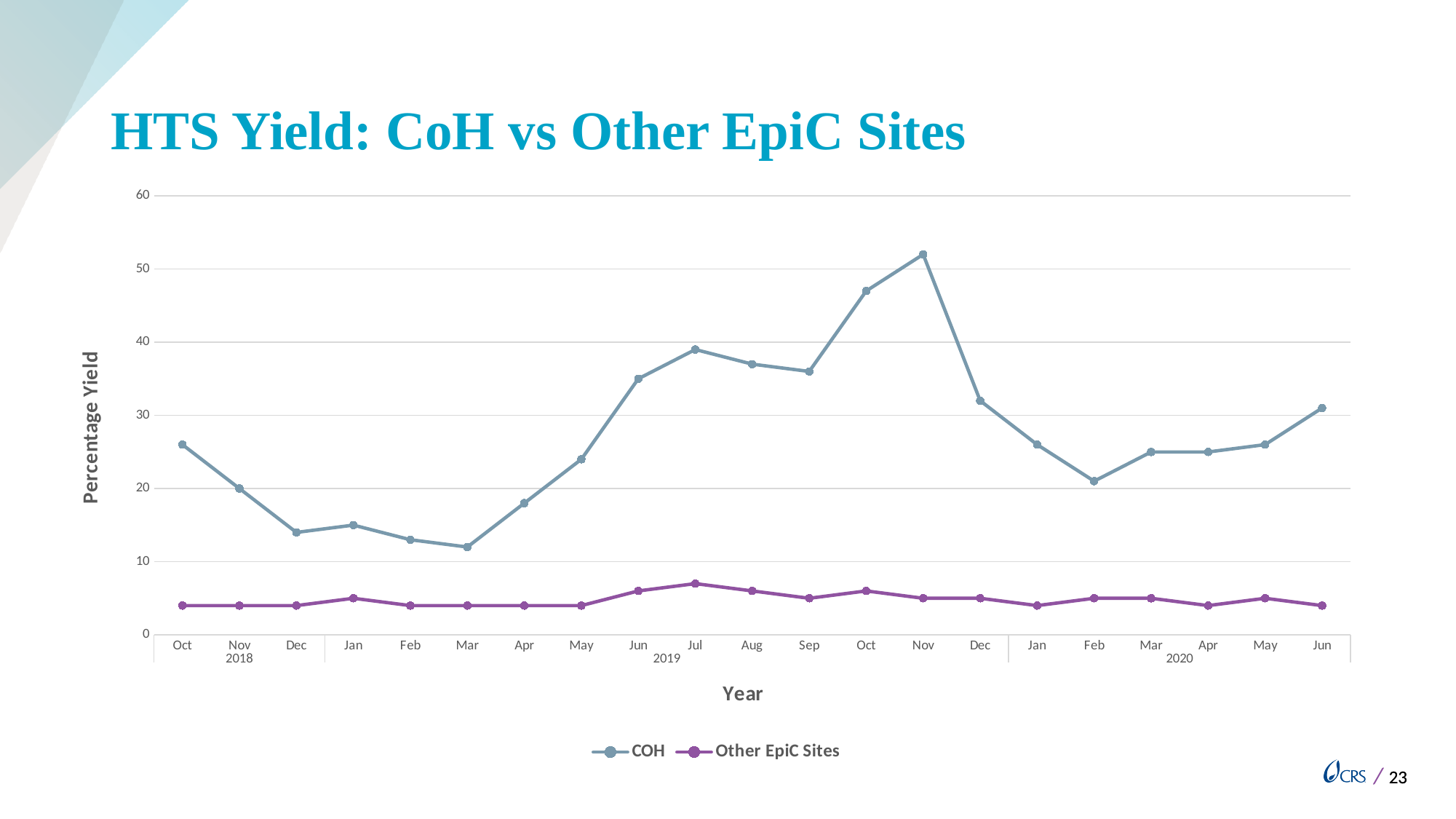
How many series does the legend list? 2 Is the COH value for Mar 2019 greater or less than 20? less How many monthly data points are plotted along the x axis? 21 What is the label on the vertical axis? Percentage Yield In which month does the Other EpiC Sites series reach its highest value? Jul 2019 In which month does the COH series reach its lowest value? Mar 2019 Is the COH value for Nov 2019 greater or less than 50? greater Does the COH series rise or fall from Oct 2018 to Mar 2019? Fall In which month does the COH series reach its highest value? Nov 2019 Which series has the larger value in Jul 2019, COH or Other EpiC Sites? COH What kind of chart is shown on the slide? Line chart